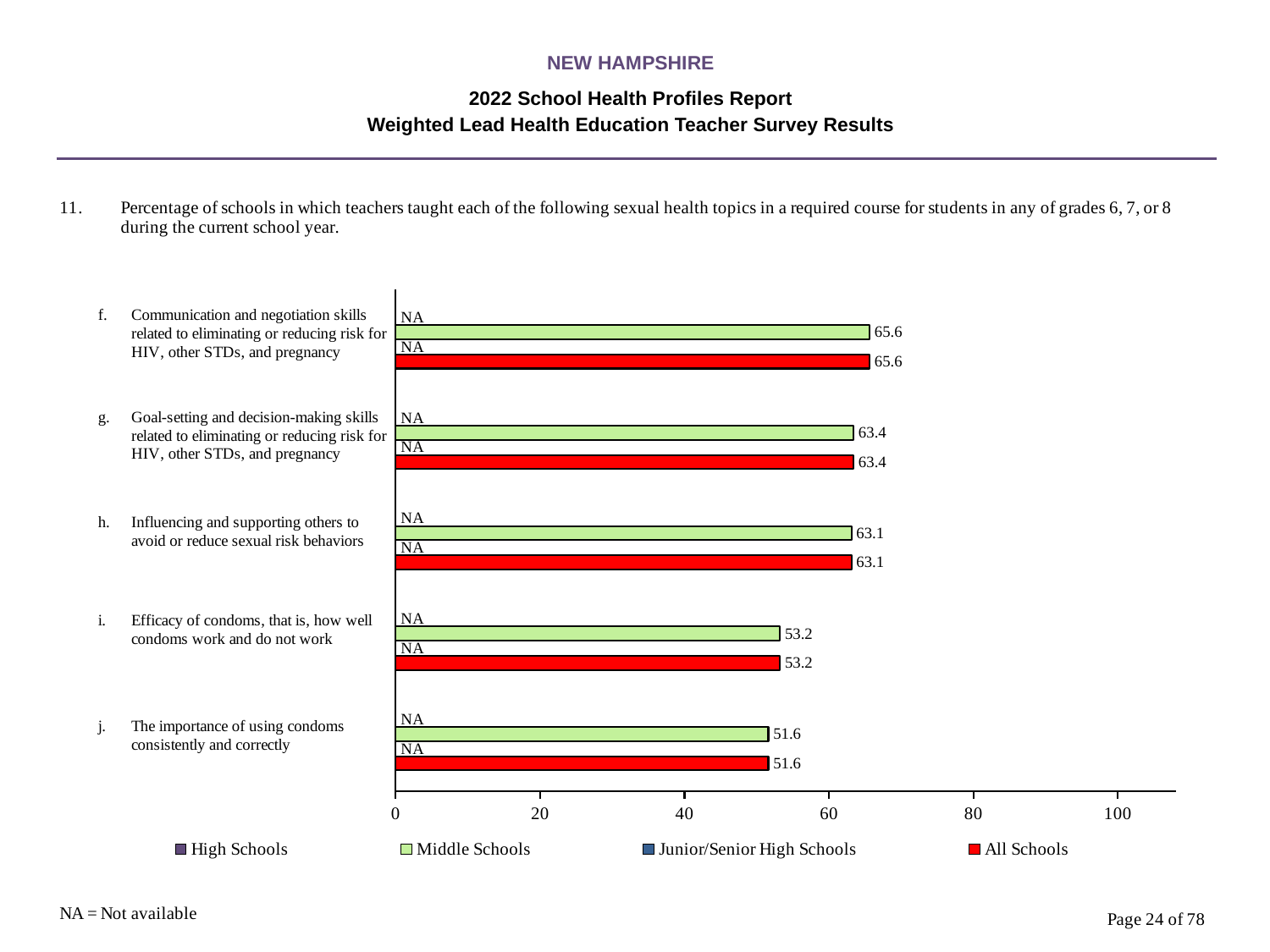
Which topic has the lowest All Schools value? j. The importance of using condoms consistently and correctly Is the Middle Schools value for topic h greater or less than 60? greater What is the All Schools value for topic j, the importance of using condoms consistently and correctly? 51.6 What is the Middle Schools value for topic f, communication and negotiation skills related to eliminating or reducing risk for HIV, other STDs, and pregnancy? 65.6 How many series does the legend list? 4 What is the difference between the Middle Schools values for topic f and topic j? 14.0 What kind of chart is shown on the slide? Bar chart How many topics are listed on the chart? 5 Which is larger: the All Schools value for topic g or for topic i? Topic g (63.4) What is the All Schools value for topic h, influencing and supporting others to avoid or reduce sexual risk behaviors? 63.1 Which topic has the highest Middle Schools value? f. Communication and negotiation skills related to eliminating or reducing risk for HIV, other STDs, and pregnancy What is the Middle Schools value for topic i, efficacy of condoms? 53.2